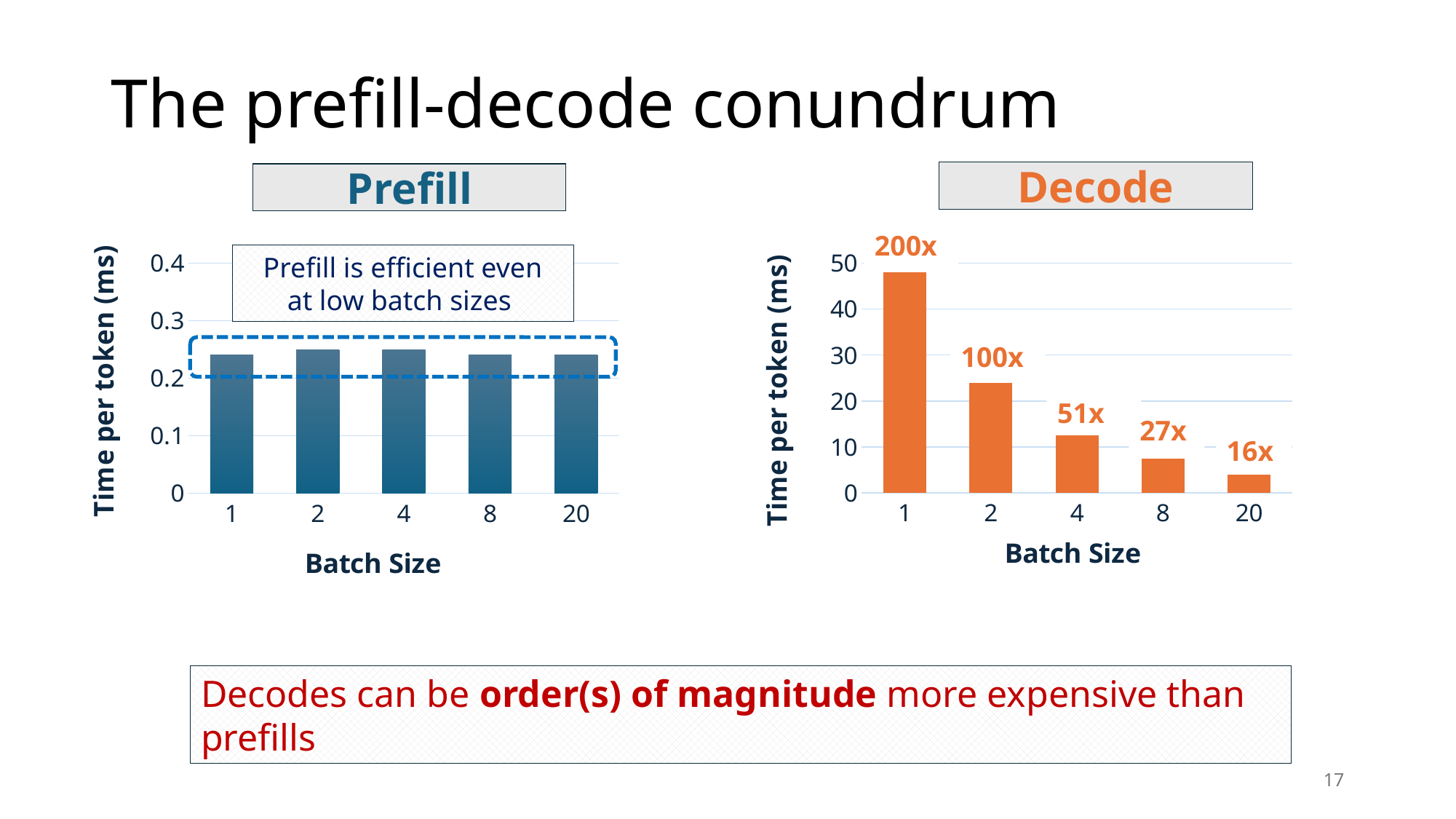
In the Decode chart, does the time per token rise or fall as batch size increases? fall In the Decode chart, what label is printed above the bar for batch size 8? 27x In the Decode chart, is the value for batch size 1 greater or less than 40? greater How many batch sizes are plotted in the Prefill chart? 5 In the Decode chart, is the value for batch size 2 greater or less than 20? greater In the Decode chart, is the value for batch size 20 greater or less than 10? less In the Decode chart, which batch size has the highest time per token? 1 In the Decode chart, which batch size has the lowest time per token? 20 What kind of chart is the Decode chart? bar chart In the Decode chart, what label is printed above the bar for batch size 1? 200x